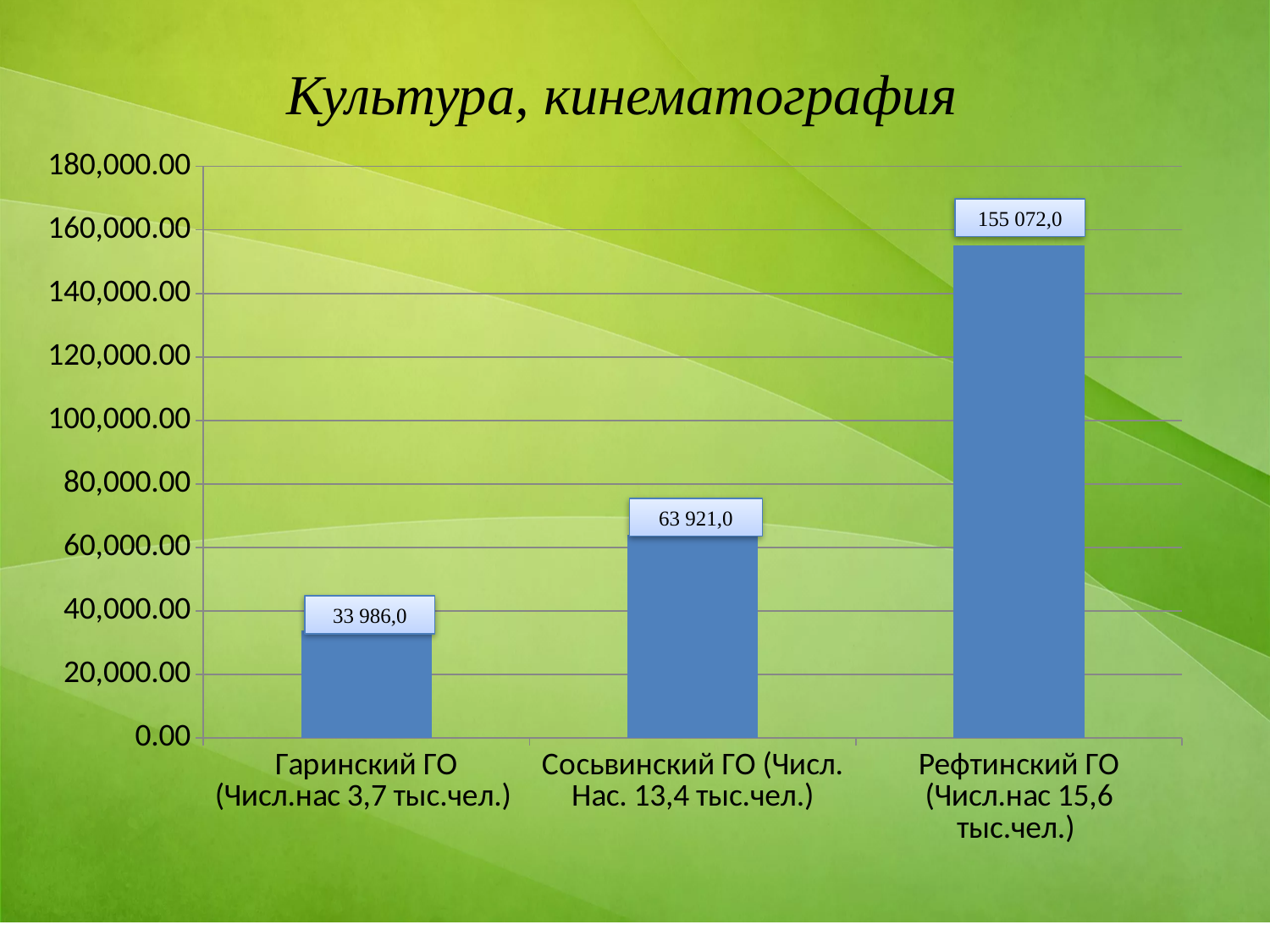
What is the difference between the values for Сосьвинский ГО and Гаринский ГО? 29 935,0 What is the difference between the values for Рефтинский ГО and Гаринский ГО? 121 086,0 Which category has the highest value? Рефтинский ГО What is the value for Рефтинский ГО? 155 072,0 How many categories are shown in the chart? 3 What is the value for Гаринский ГО? 33 986,0 What is the value for Сосьвинский ГО? 63 921,0 Which category has the lowest value? Гаринский ГО What kind of chart is shown on the slide? bar chart Is the value for Рефтинский ГО greater or less than 140,000.00? greater Which is larger, the value for Сосьвинский ГО or the value for Гаринский ГО? Сосьвинский ГО What is the title of the chart? Культура, кинематография